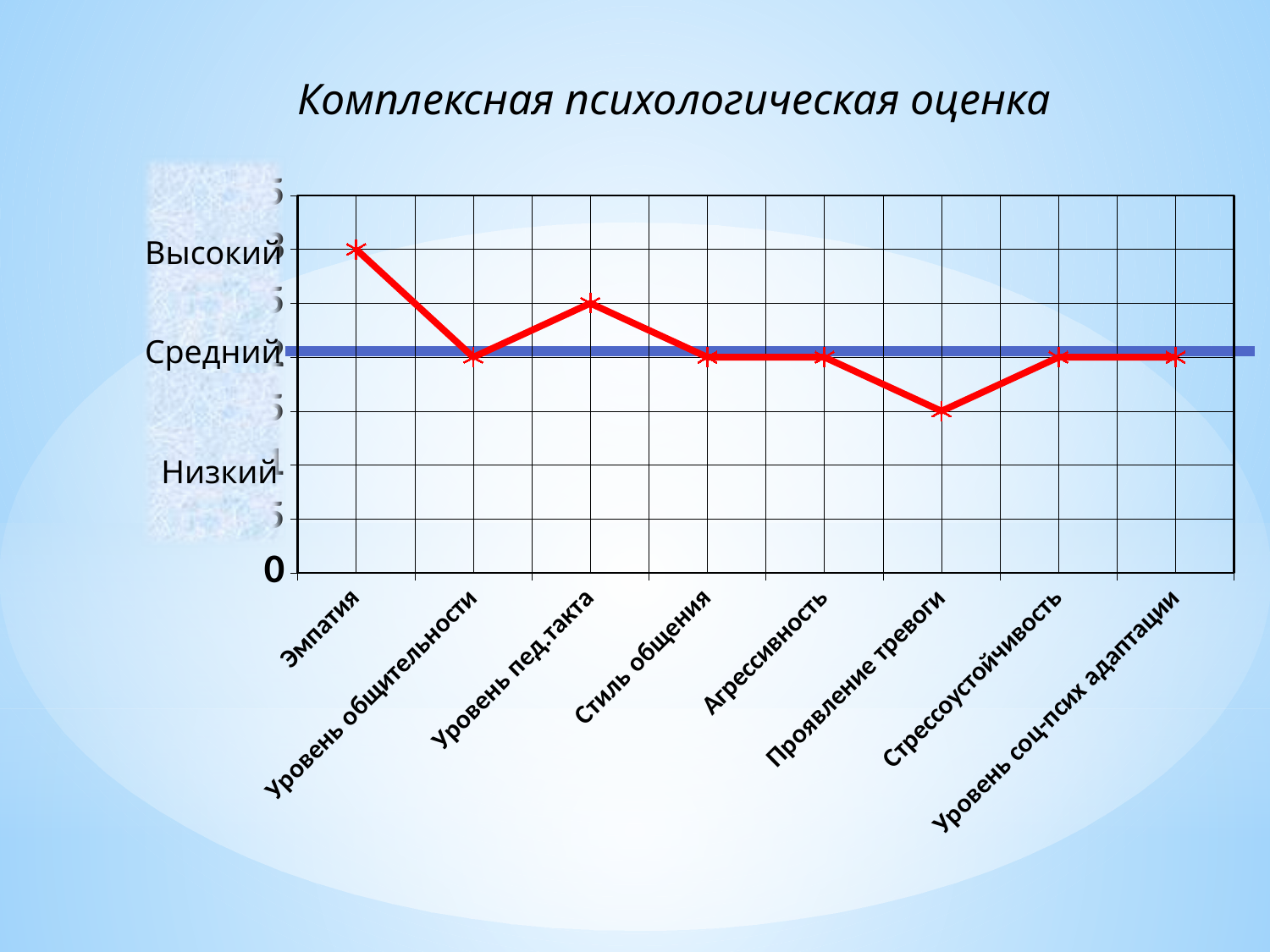
Which category has the lowest value? Проявление тревоги Does the line rise or fall from Проявление тревоги to Стрессоустойчивость? rise Which is larger, the value for Уровень пед.такта or the value for Проявление тревоги? Уровень пед.такта Which level label on the y axis does the point for Эмпатия line up with? Высокий How many categories are plotted along the x axis? 8 Which is larger, the value for Эмпатия or the value for Уровень пед.такта? Эмпатия What kind of chart is shown on the slide? line chart Which category has the highest value? Эмпатия What is the title of the chart? Комплексная психологическая оценка At which level label is the thick blue horizontal line drawn? Средний Does the line rise or fall from Эмпатия to Уровень общительности? fall Which level label on the y axis does the point for Агрессивность line up with? Средний